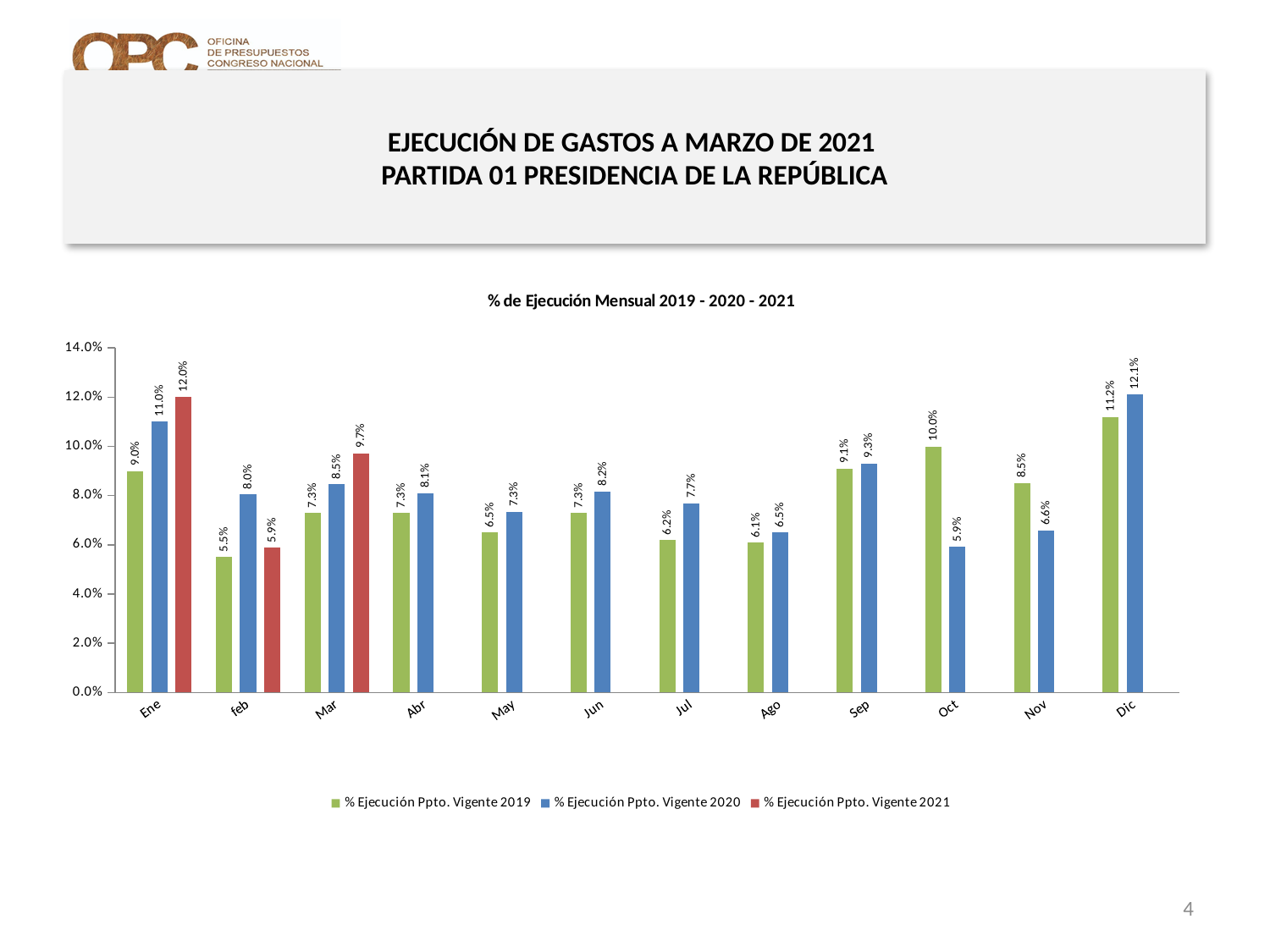
Which is larger in Nov: the 2019 value or the 2020 value? 2019 What is the value for % Ejecución Ppto. Vigente 2019 in Oct? 10.0% Is the value for % Ejecución Ppto. Vigente 2020 in Ene greater or less than 10.0%? greater What is the value for % Ejecución Ppto. Vigente 2021 in Ene? 12.0% What kind of chart is shown? bar chart How many months are shown on the x axis? 12 Which month has the highest value for % Ejecución Ppto. Vigente 2019? Dic What is the value for % Ejecución Ppto. Vigente 2020 in Dic? 12.1% Which month has the lowest value for % Ejecución Ppto. Vigente 2020? Oct What is the title of the chart? % de Ejecución Mensual 2019 - 2020 - 2021 What is the difference between the 2021 and 2020 values in Mar? 1.2% How many series does the legend list? 3